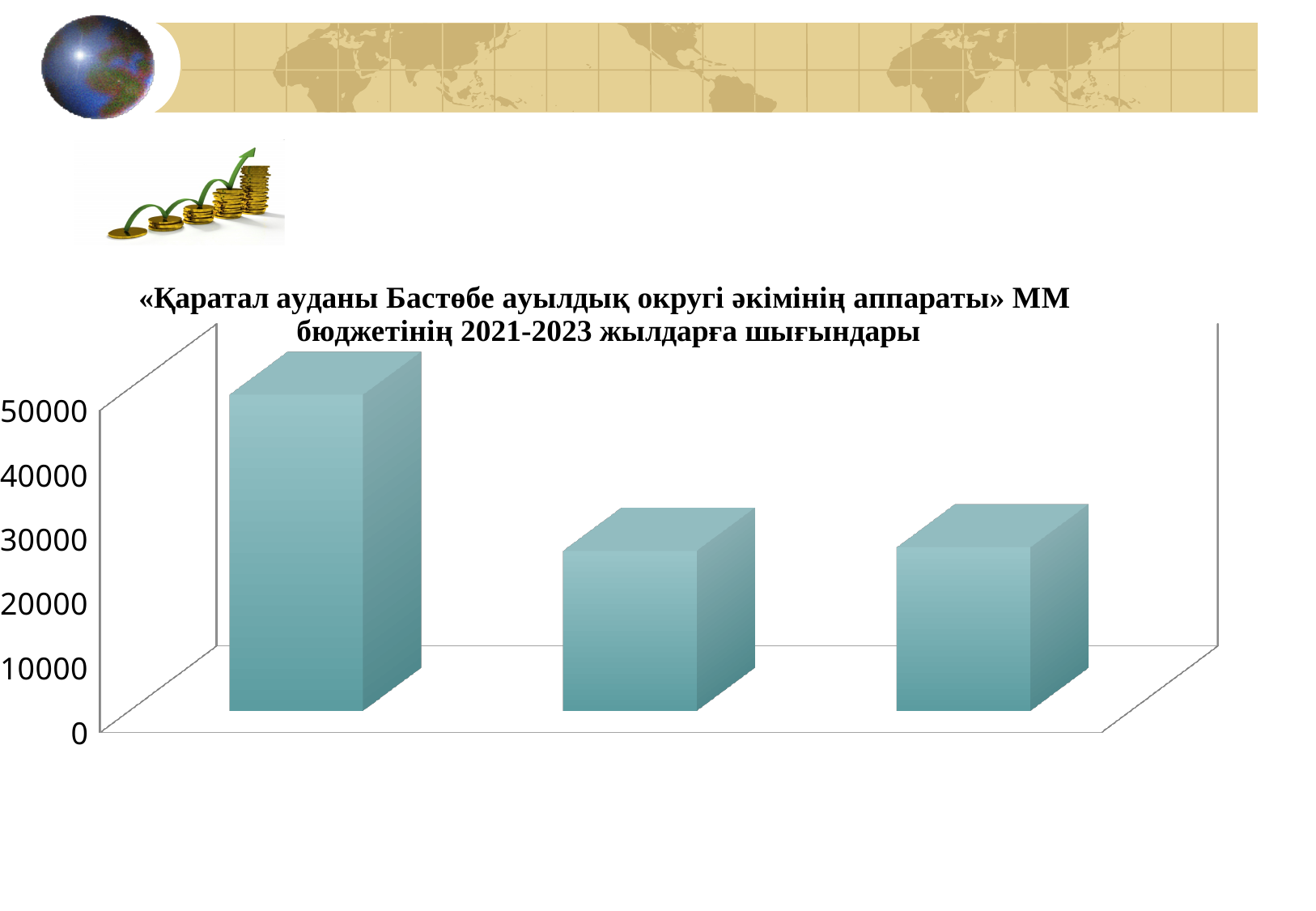
Is the value of the leftmost bar greater or less than 40000? greater What kind of chart is shown on the slide? bar chart Which is larger, the value of the leftmost bar or the value of the rightmost bar? the leftmost bar Which bar has the highest value: the leftmost, the middle, or the rightmost? the leftmost Is the value of the rightmost bar greater or less than 20000? greater What years does the chart title say the expenditures cover? 2021-2023 Is the value of the middle bar greater or less than 20000? greater Does the value fall or rise from the leftmost bar to the middle bar? fall What is the highest value labelled on the vertical axis? 50000 How many bars are plotted in the chart? 3